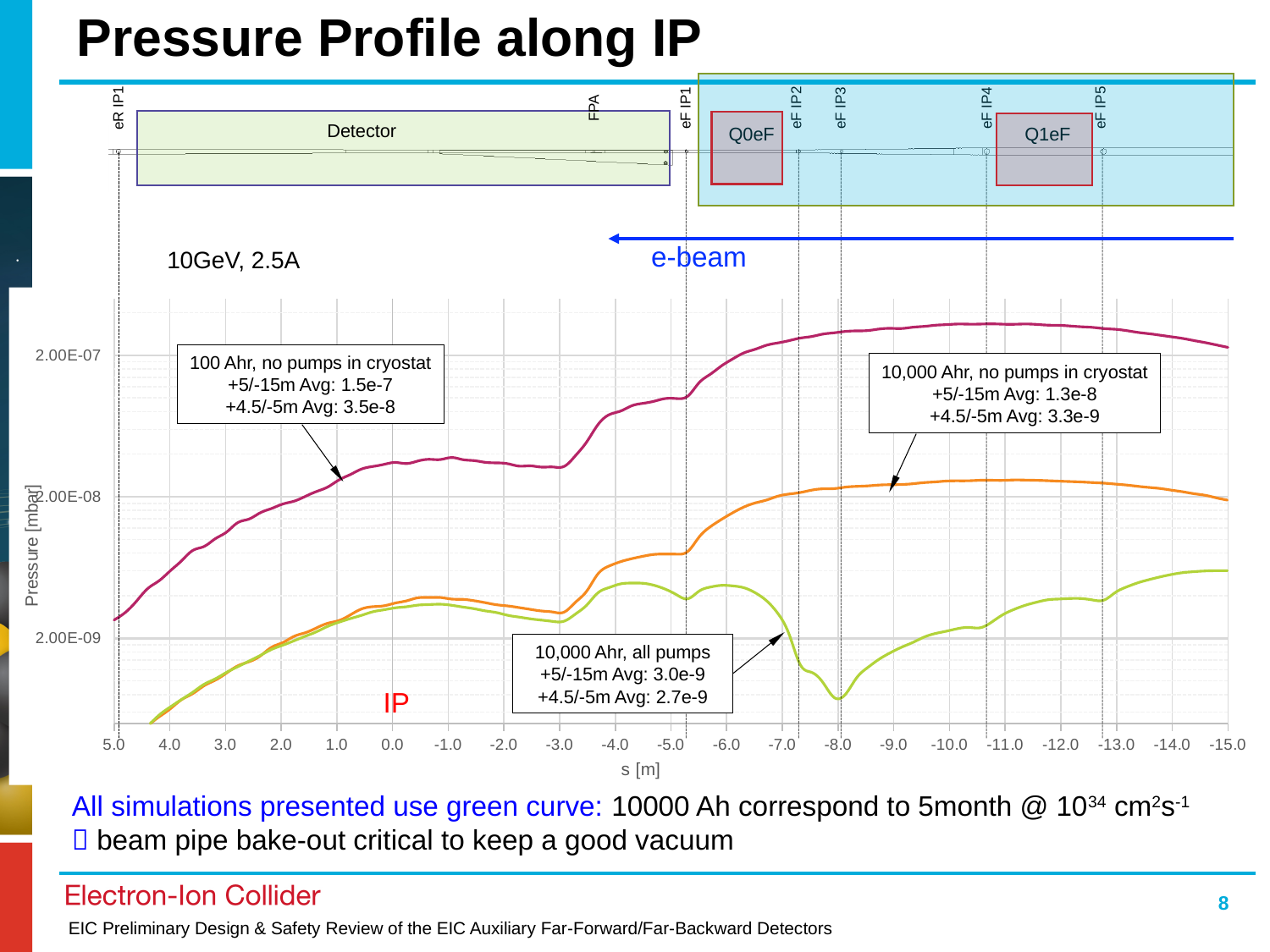
What is the +5/-15m average pressure for the 10,000 Ahr, no pumps in cryostat curve? 1.3e-8 Which curve has the highest pressure across the profile: 100 Ahr no pumps in cryostat, 10,000 Ahr no pumps in cryostat, or 10,000 Ahr all pumps? 100 Ahr, no pumps in cryostat How many pressure curves are plotted on the chart? 3 What is the label of the x axis of the chart? s [m] What is the +5/-15m average pressure for the 100 Ahr, no pumps in cryostat curve? 1.5e-7 Is the pressure of the 100 Ahr, no pumps in cryostat curve at s = -10.0 m greater or less than 2.00E-07? greater What is the +5/-15m average pressure for the 10,000 Ahr, all pumps curve? 3.0e-9 Is the pressure of the 10,000 Ahr, all pumps curve at s = -8.0 m greater or less than 2.00E-09? less What kind of chart is shown on the slide? line chart What is the label of the y axis of the chart? Pressure [mbar] What is the +4.5/-5m average pressure for the 10,000 Ahr, all pumps curve? 2.7e-9 What is the +4.5/-5m average pressure for the 100 Ahr, no pumps in cryostat curve? 3.5e-8